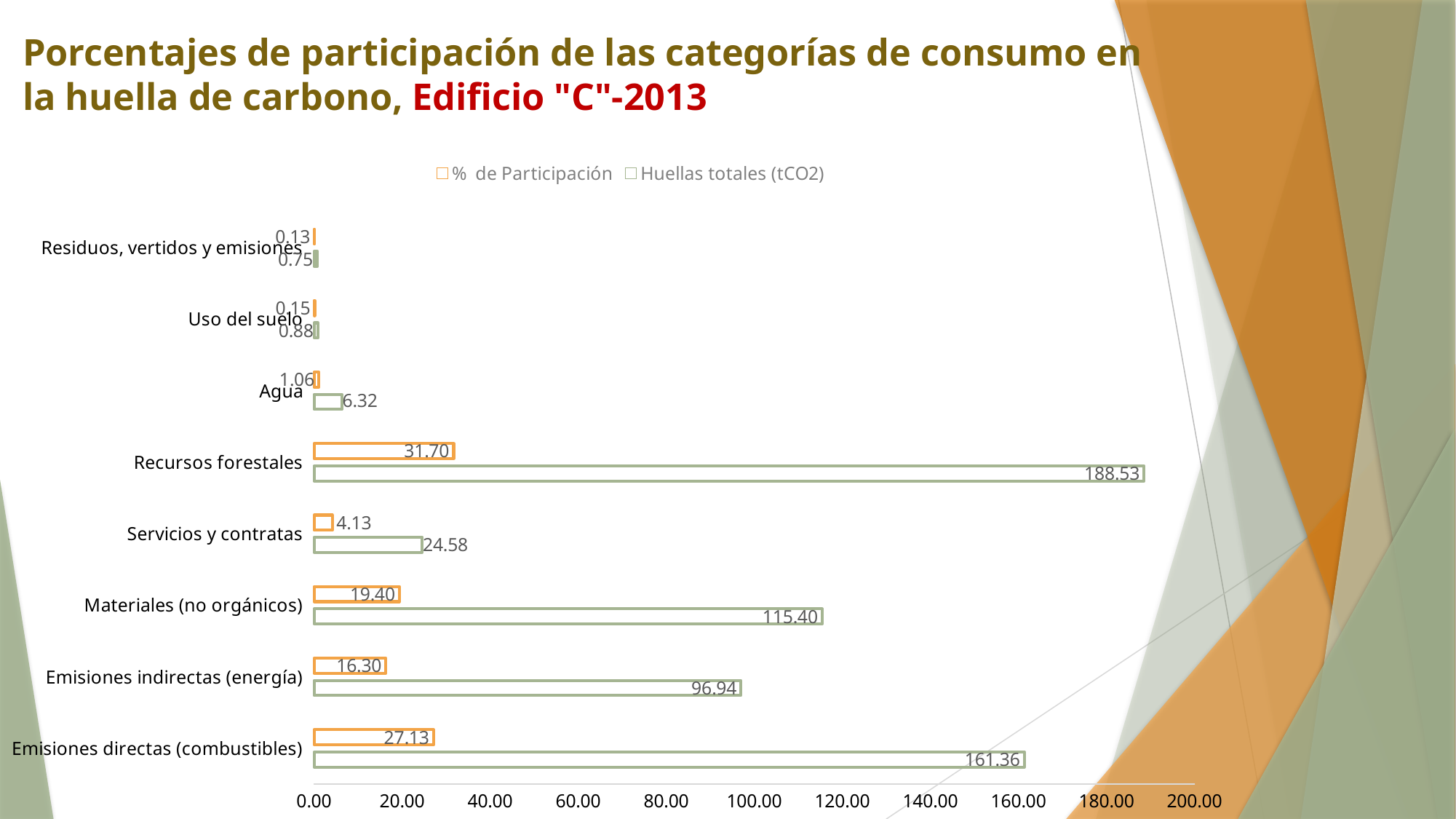
Which category has the lowest % de Participación value? Residuos, vertidos y emisiones Which has a larger Huellas totales (tCO2) value, Materiales (no orgánicos) or Emisiones indirectas (energía)? Materiales (no orgánicos) What is the % de Participación value for Emisiones directas (combustibles)? 27.13 Is the Huellas totales (tCO2) value for Emisiones directas (combustibles) greater or less than 140.00? greater What is the difference between the Huellas totales (tCO2) values for Recursos forestales and Emisiones directas (combustibles)? 27.17 Which category has the highest Huellas totales (tCO2) value? Recursos forestales How many series does the legend list? 2 What is the Huellas totales (tCO2) value for Recursos forestales? 188.53 What is the % de Participación value for Servicios y contratas? 4.13 What kind of chart is shown on the slide? Bar chart How many categories are shown on the chart? 8 What is the Huellas totales (tCO2) value for Materiales (no orgánicos)? 115.40